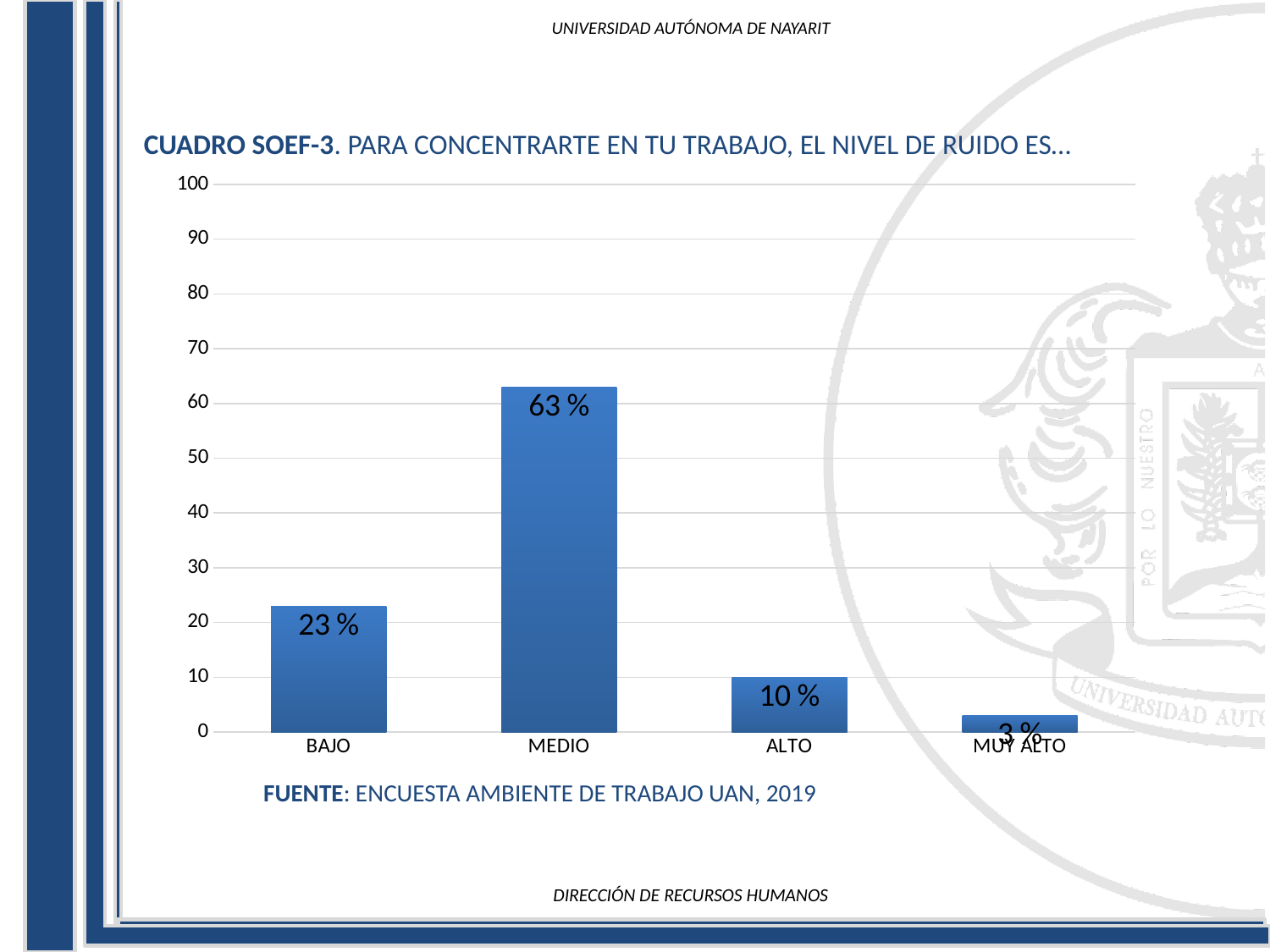
Which is larger, the value for BAJO or the value for ALTO? BAJO What is the value for ALTO? 10 % What kind of chart is shown on the slide? bar chart Is the value for MEDIO greater or less than 50? greater Which category has the lowest value? MUY ALTO Which category has the highest value? MEDIO How many categories are shown on the x axis? 4 What source is cited below the chart? ENCUESTA AMBIENTE DE TRABAJO UAN, 2019 What is the difference between the values for BAJO and ALTO? 13 % What is the value for MEDIO? 63 % What is the difference between the values for MEDIO and BAJO? 40 % What is the value for BAJO? 23 %